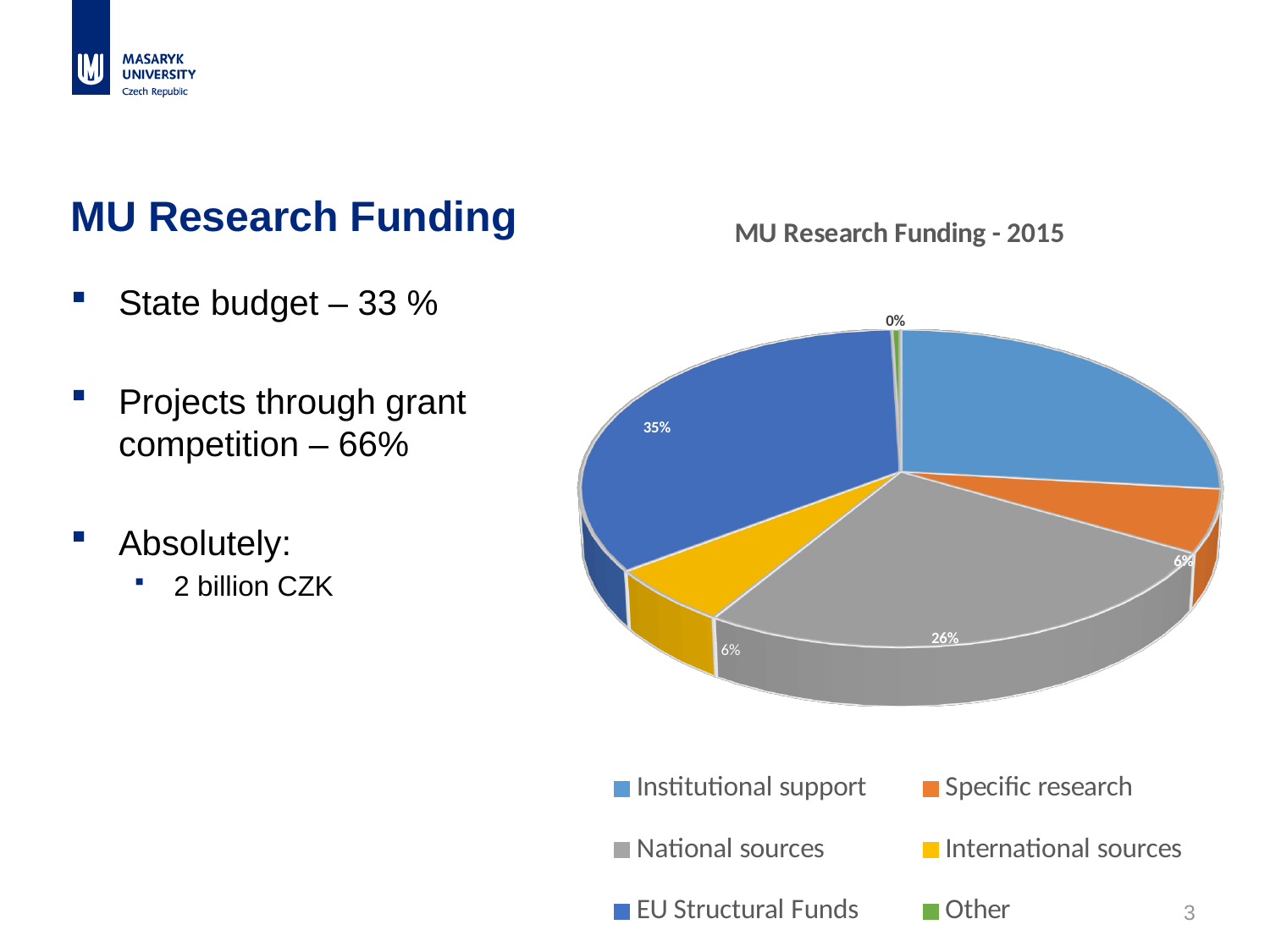
What share of MU research funding in 2015 came from International sources? 6% What share of MU research funding in 2015 came from Specific research? 6% What is the title of the pie chart? MU Research Funding - 2015 What share of MU research funding in 2015 came from National sources? 26% Which funding source has the smallest share in the pie chart? Other What kind of chart is shown on the slide? Pie chart What share of MU research funding in 2015 is labelled for the Other category? 0% By how many percentage points does the EU Structural Funds share exceed the National sources share? 9 percentage points What share of MU research funding in 2015 came from EU Structural Funds? 35% How many funding categories does the pie chart's legend list? 6 Which funding source has the largest share in the pie chart? EU Structural Funds Which has a larger share, National sources or Specific research? National sources